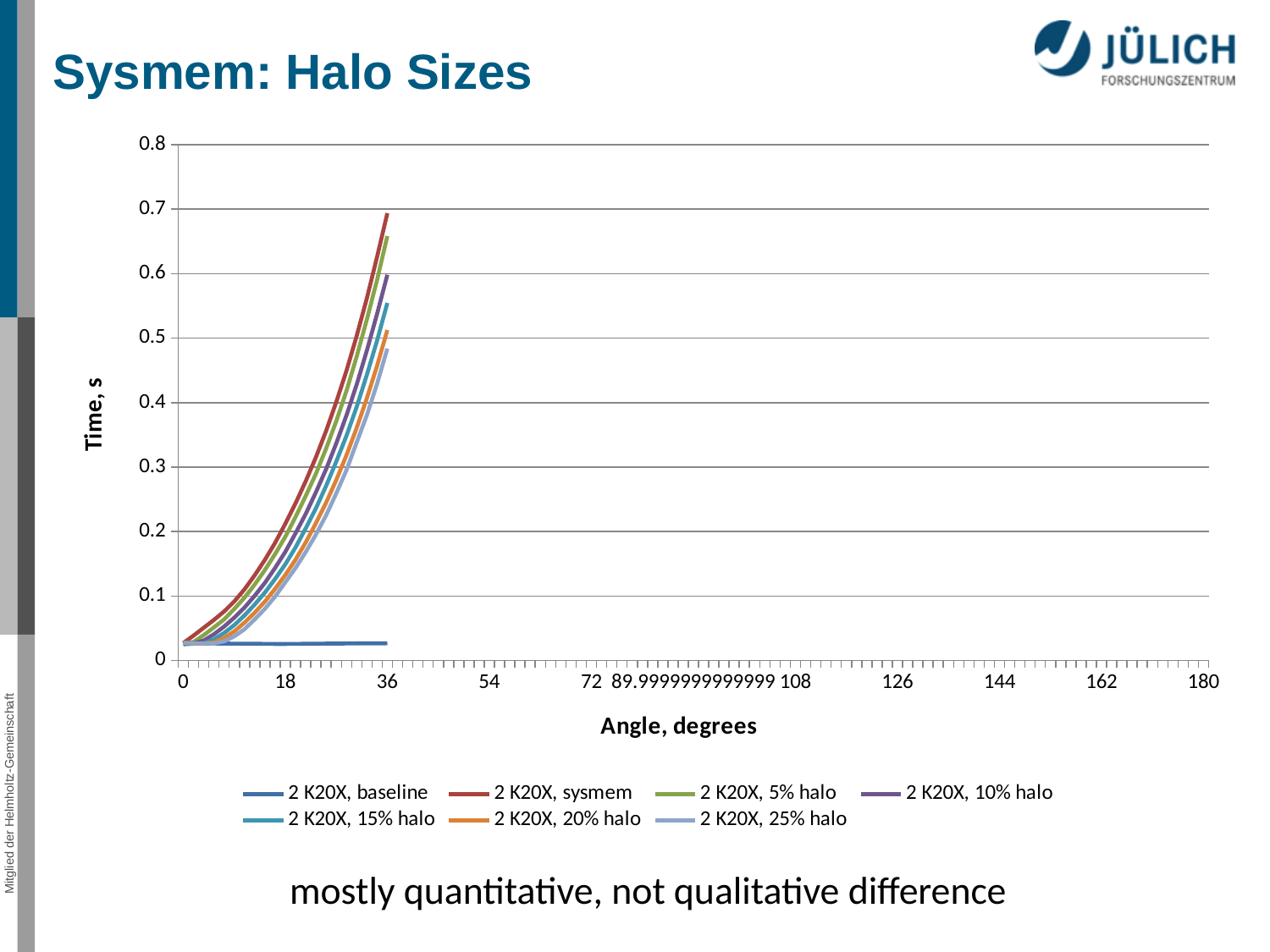
What is the title of the x axis? Angle, degrees Does the 2 K20X, sysmem series rise or fall as the angle increases from 0 to 36 degrees? rise At 36 degrees, which is larger: 2 K20X, sysmem or 2 K20X, baseline? 2 K20X, sysmem Is the value for 2 K20X, baseline at 36 degrees greater or less than 0.1? less Is the value for 2 K20X, sysmem at 36 degrees greater or less than 0.6? greater Which series has the highest value at 36 degrees? 2 K20X, sysmem Is the value for 2 K20X, 25% halo at 36 degrees greater or less than 0.6? less What is the title of the y axis? Time, s How many series does the legend list? 7 What kind of chart is shown on the slide? line chart Which series has the lowest value at 36 degrees? 2 K20X, baseline